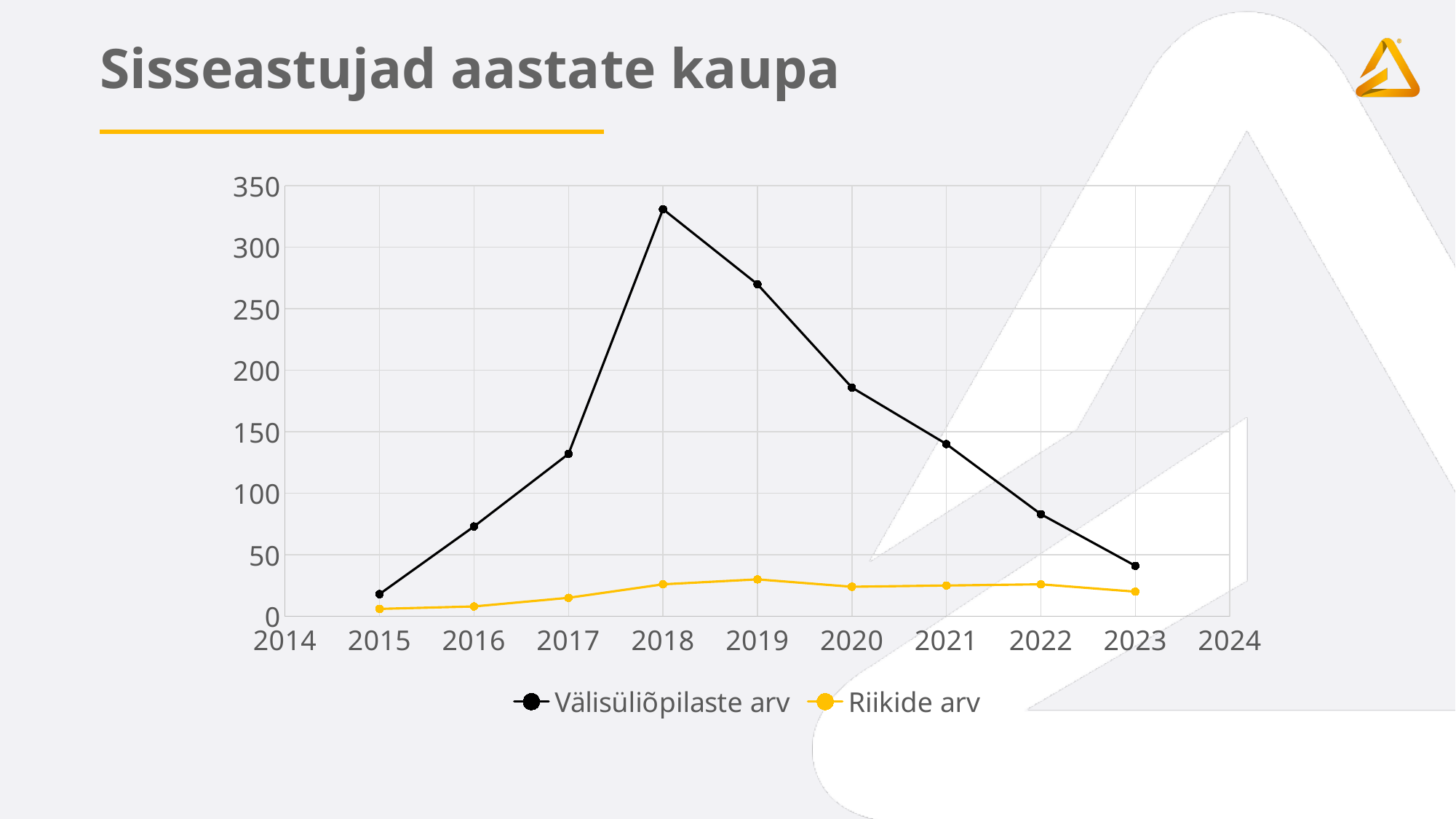
What kind of chart is shown on the slide? line chart Does Välisüliõpilaste arv rise or fall from 2018 to 2023? fall Is the value for Riikide arv in 2019 greater or less than 50? less In which year is Välisüliõpilaste arv lowest? 2015 How many series does the legend list? 2 Is the value for Välisüliõpilaste arv in 2023 greater or less than 50? less Is the value for Välisüliõpilaste arv in 2018 greater or less than 300? greater What colour is the Riikide arv line? yellow How many data points does the Välisüliõpilaste arv line have? 9 Which is larger, Välisüliõpilaste arv in 2019 or in 2020? 2019 In which year is Välisüliõpilaste arv highest? 2018 What is the title of the slide? Sisseastujad aastate kaupa